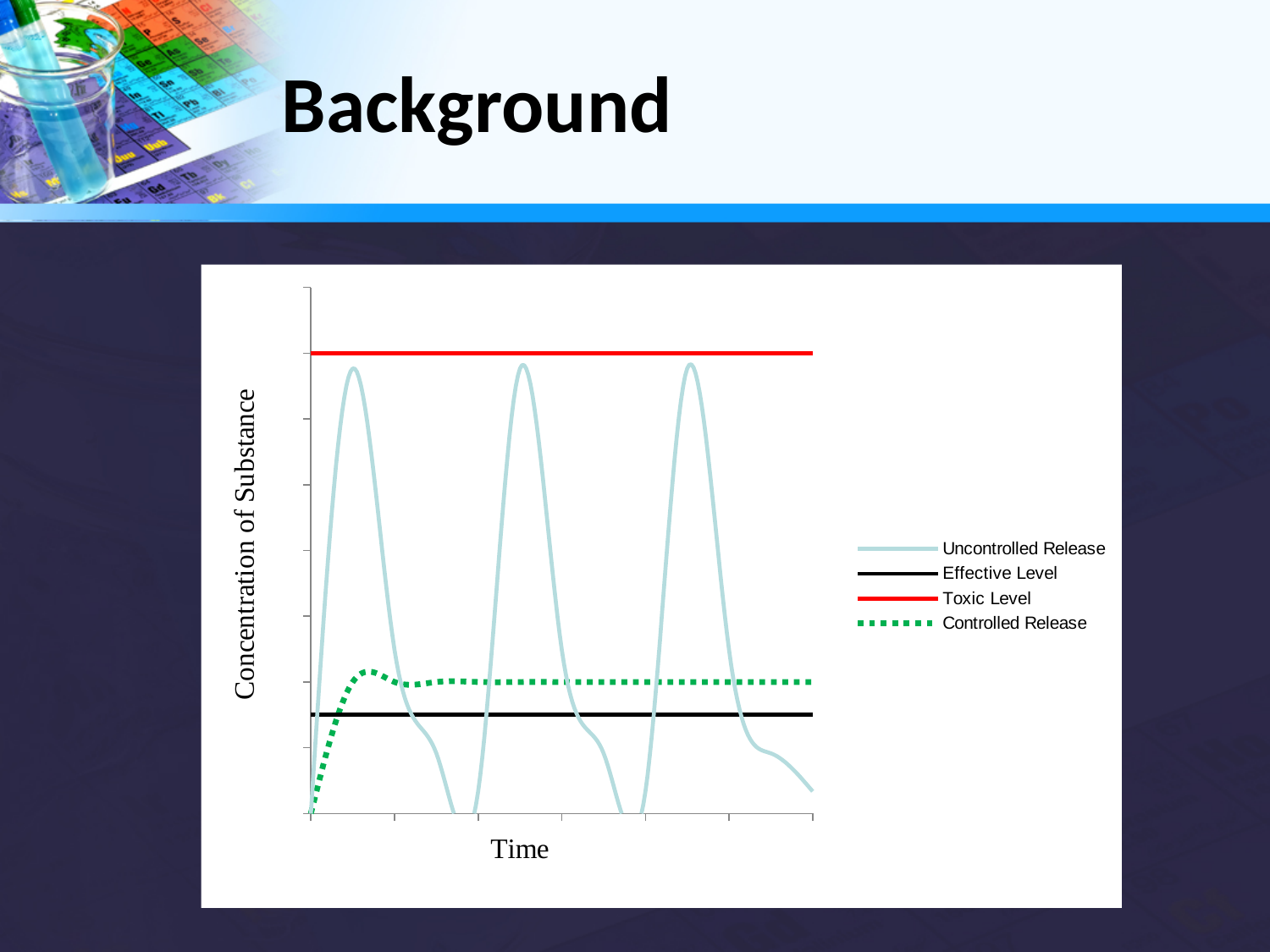
Does the Controlled Release line rise, fall, or stay flat over the later part of the time axis? stay flat Does the Controlled Release line stay above or below the Effective Level line after its initial rise? above How many series does the legend list? 4 Which series is drawn as a dotted green line? Controlled Release What is the label on the vertical axis? Concentration of Substance What kind of chart is shown on the slide? line chart Which series is drawn in red? Toxic Level How many peaks does the Uncontrolled Release line show? 3 Do the peaks of the Uncontrolled Release line reach above or stay below the Toxic Level line? below Which series has the highest value on the chart? Toxic Level Which is higher on the chart, the Toxic Level line or the Effective Level line? Toxic Level